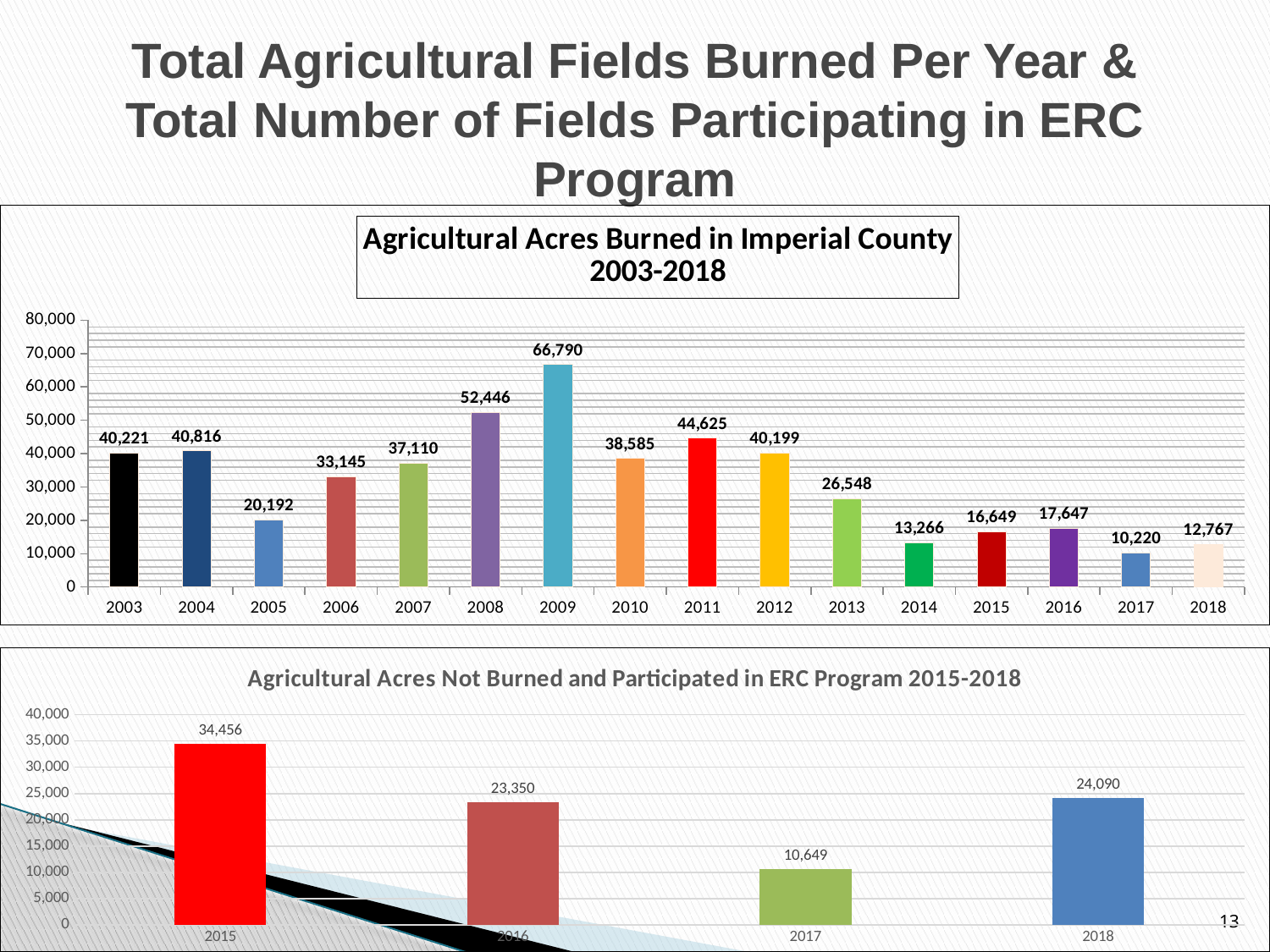
In the 'Agricultural Acres Burned in Imperial County 2003-2018' chart, which year has the highest value? 2009 In the 'Agricultural Acres Burned in Imperial County 2003-2018' chart, what is the difference between the values for 2008 and 2007? 15,336 In the 'Agricultural Acres Burned in Imperial County 2003-2018' chart, how many years are shown? 16 In the 'Agricultural Acres Burned in Imperial County 2003-2018' chart, what is the value for 2009? 66,790 In the 'Agricultural Acres Not Burned and Participated in ERC Program 2015-2018' chart, what is the value for 2016? 23,350 In the 'Agricultural Acres Burned in Imperial County 2003-2018' chart, which year has the lowest value? 2017 In the 'Agricultural Acres Not Burned and Participated in ERC Program 2015-2018' chart, how many years are shown? 4 In the 'Agricultural Acres Burned in Imperial County 2003-2018' chart, what is the value for 2014? 13,266 In the 'Agricultural Acres Not Burned and Participated in ERC Program 2015-2018' chart, what is the difference between the values for 2018 and 2017? 13,441 In the 'Agricultural Acres Burned in Imperial County 2003-2018' chart, which is larger, the value for 2011 or the value for 2012? 2011 In the 'Agricultural Acres Not Burned and Participated in ERC Program 2015-2018' chart, which year has the highest value? 2015 What kind of chart is the bottom chart on the slide? Bar chart